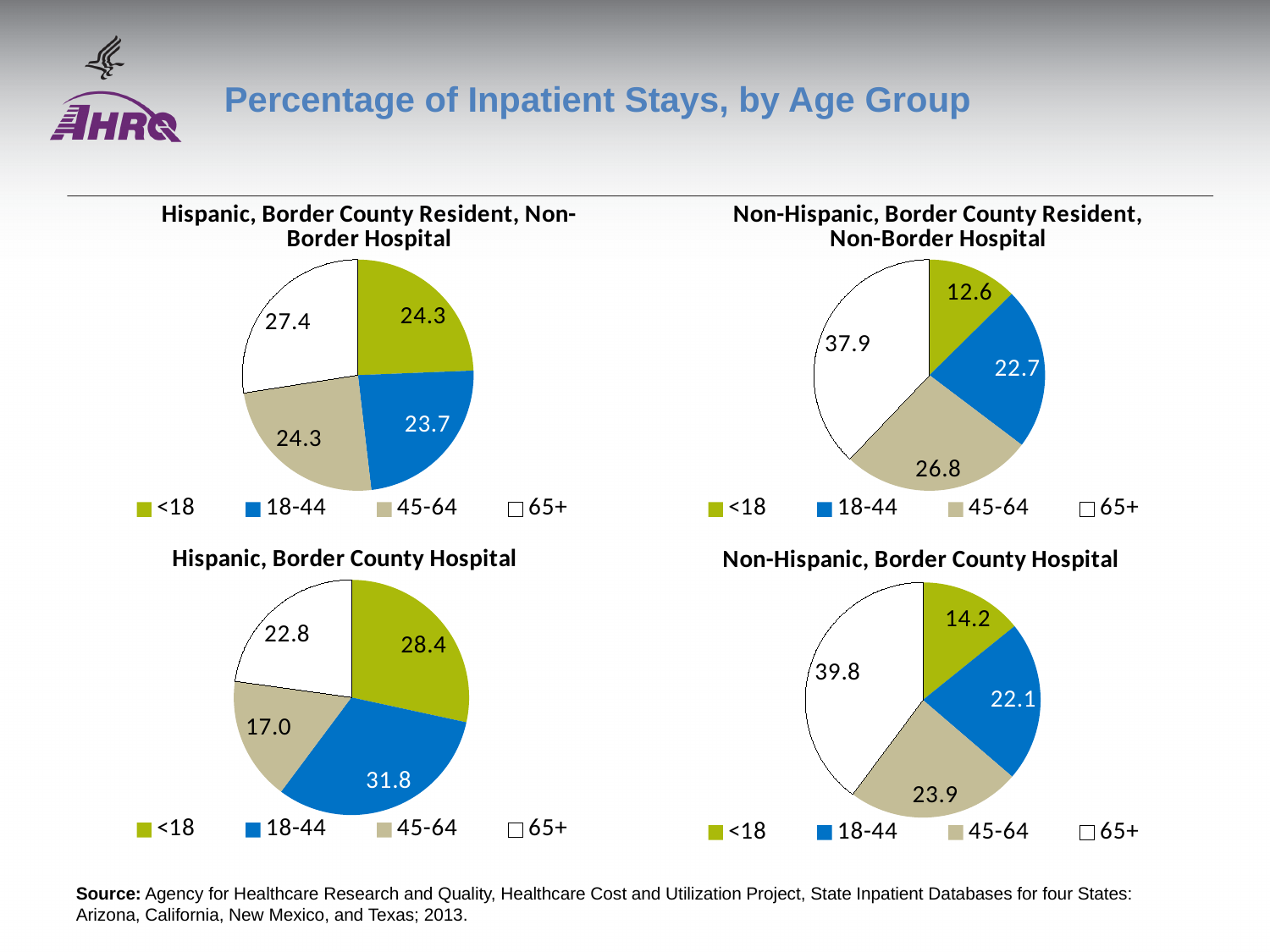
In the 'Non-Hispanic, Border County Resident, Non-Border Hospital' chart, which age group has the smallest share? <18 How many age groups does the legend list for each pie chart? 4 In the 'Hispanic, Border County Hospital' chart, which age group has the smallest share? 45-64 In the 'Hispanic, Border County Hospital' chart, what is the value for the 18-44 age group? 31.8 In the 'Non-Hispanic, Border County Hospital' chart, which age group has the largest share? 65+ In the 'Non-Hispanic, Border County Resident, Non-Border Hospital' chart, what is the value for the <18 age group? 12.6 In the 'Non-Hispanic, Border County Resident, Non-Border Hospital' chart, what is the difference between the 65+ and <18 values? 25.3 How many pie charts are shown on the slide? 4 In the 'Non-Hispanic, Border County Hospital' chart, what is the value for the 45-64 age group? 23.9 What type of chart is used on this slide? Pie chart In the 'Hispanic, Border County Hospital' chart, which is larger: the 18-44 value or the <18 value? 18-44 In the 'Hispanic, Border County Resident, Non-Border Hospital' chart, what is the value for the 65+ age group? 27.4